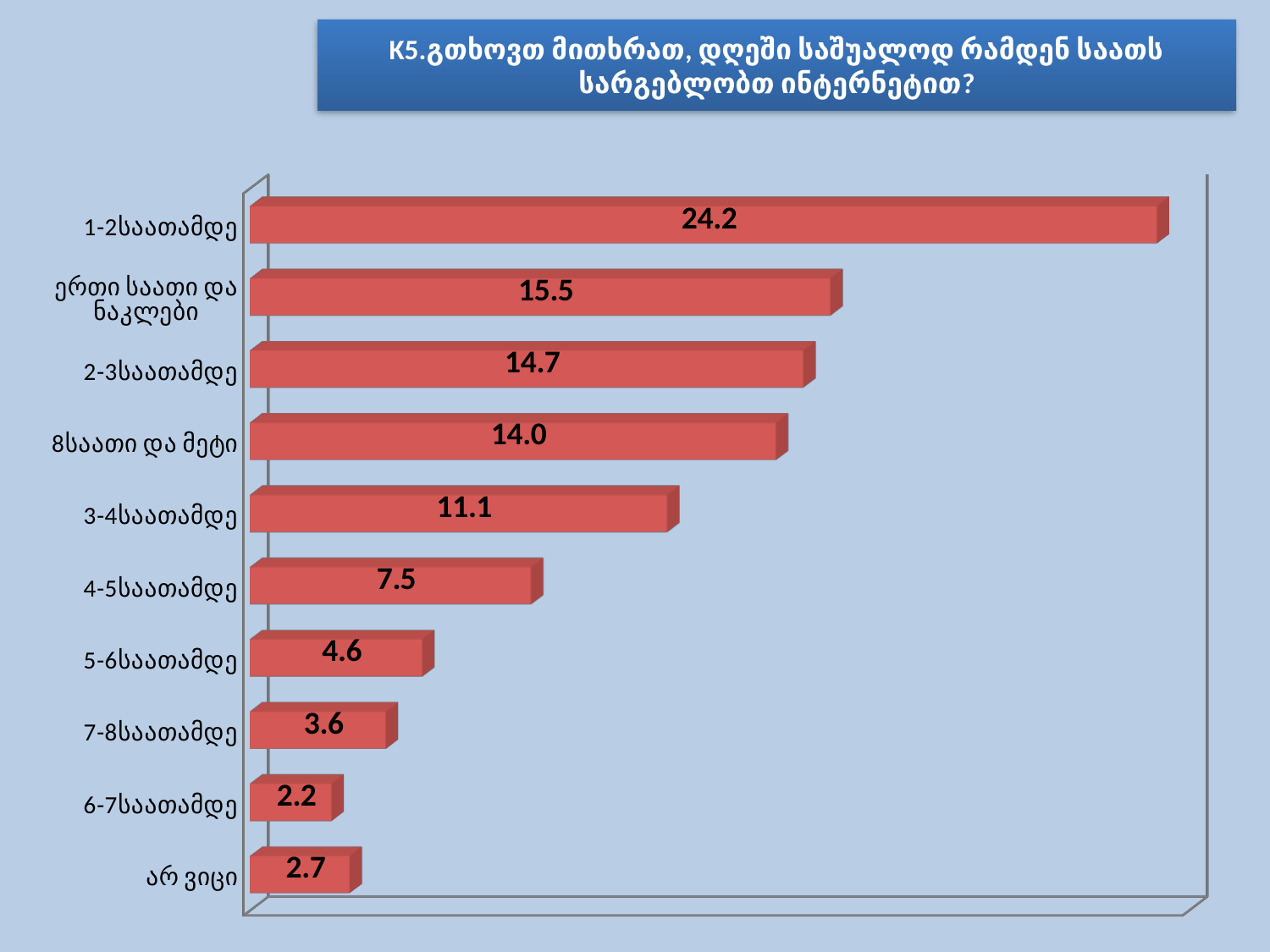
What is the value for the category "ერთი საათი და ნაკლები"? 15.5 Which category has the lowest value? 6-7საათამდე What is the difference between the values for "3-4საათამდე" and "4-5საათამდე"? 3.6 What colour are the bars in the chart? Red What is the value for the category "არ ვიცი"? 2.7 What is the value for the category "8საათი და მეტი"? 14.0 What kind of chart is shown on the slide? Bar chart What is the value for the category "1-2საათამდე"? 24.2 How many categories are shown in the chart? 10 Which category has the highest value? 1-2საათამდე Which is larger, the value for "2-3საათამდე" or the value for "8საათი და მეტი"? 2-3საათამდე What is the difference between the values for "1-2საათამდე" and "ერთი საათი და ნაკლები"? 8.7